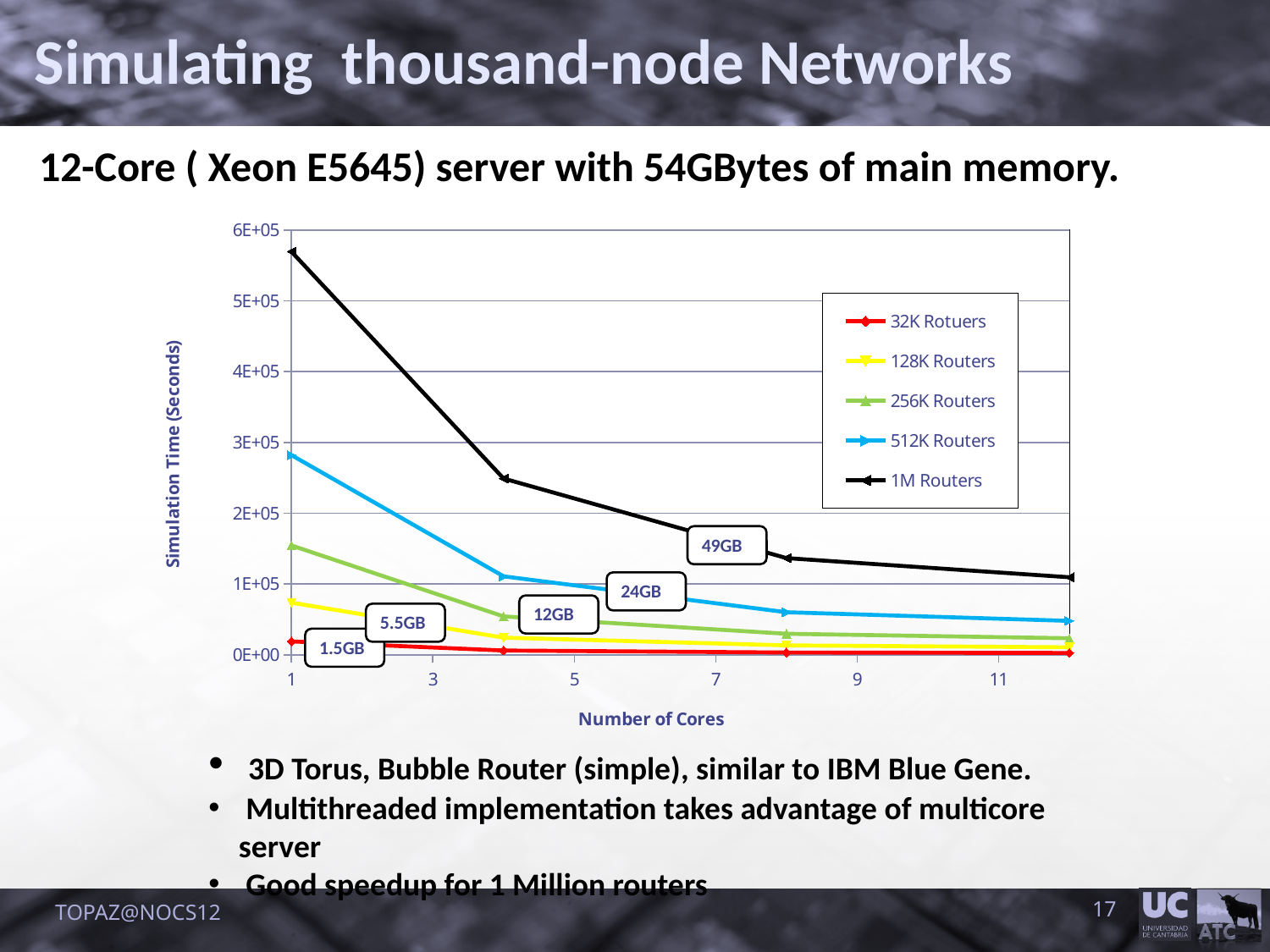
What is the title of the chart's x axis? Number of Cores Which series has the lowest simulation time across the number of cores? 32K Rotuers What kind of chart is shown on the slide? line chart How many series does the chart legend list? 5 Is the simulation time for 1M Routers at 1 core greater or less than 5E+05 seconds? greater What colour is the line for the 1M Routers series? black Is the simulation time for 1M Routers at 12 cores greater or less than 2E+05 seconds? less Does the simulation time for 1M Routers rise or fall as the number of cores increases? fall Is the simulation time for 512K Routers at 1 core greater or less than 2E+05 seconds? greater Which series has the highest simulation time at 1 core? 1M Routers At 1 core, which has the larger simulation time: 512K Routers or 256K Routers? 512K Routers